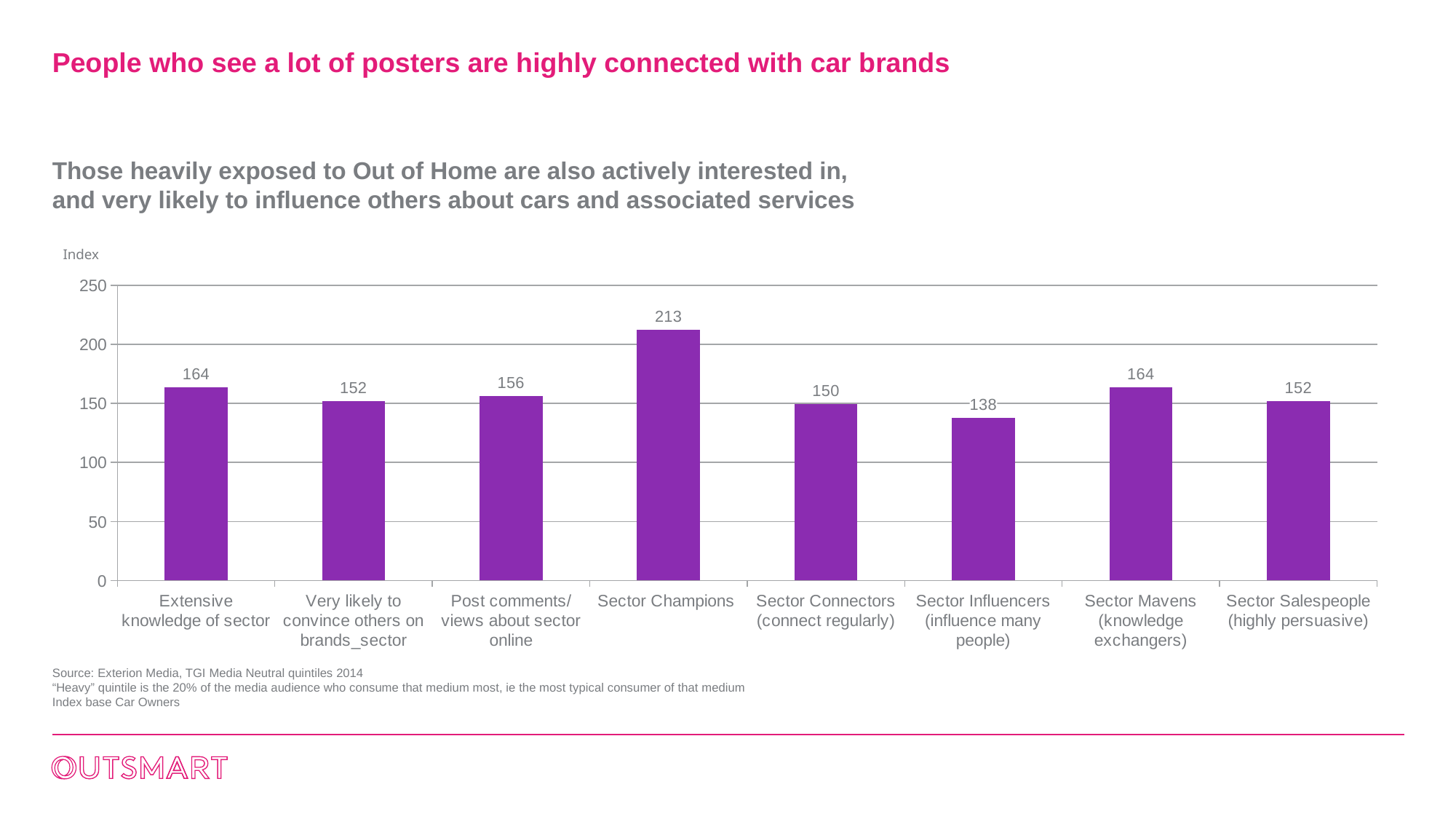
What kind of chart is shown on the slide? Bar chart What is the label on the vertical axis of the chart? Index Is the index value for Sector Influencers (influence many people) greater or less than 150? less Which category has the highest index value? Sector Champions What is the difference between the index values for Sector Mavens (knowledge exchangers) and Sector Influencers (influence many people)? 26 Which is larger, the index value for Extensive knowledge of sector or for Sector Salespeople (highly persuasive)? Extensive knowledge of sector What is the difference between the index values for Sector Champions and Sector Connectors (connect regularly)? 63 How many categories are shown on the chart? 8 What is the index value for Post comments/views about sector online? 156 What is the index value for Sector Champions? 213 Which category has the lowest index value? Sector Influencers (influence many people) What is the index value for Sector Influencers (influence many people)? 138